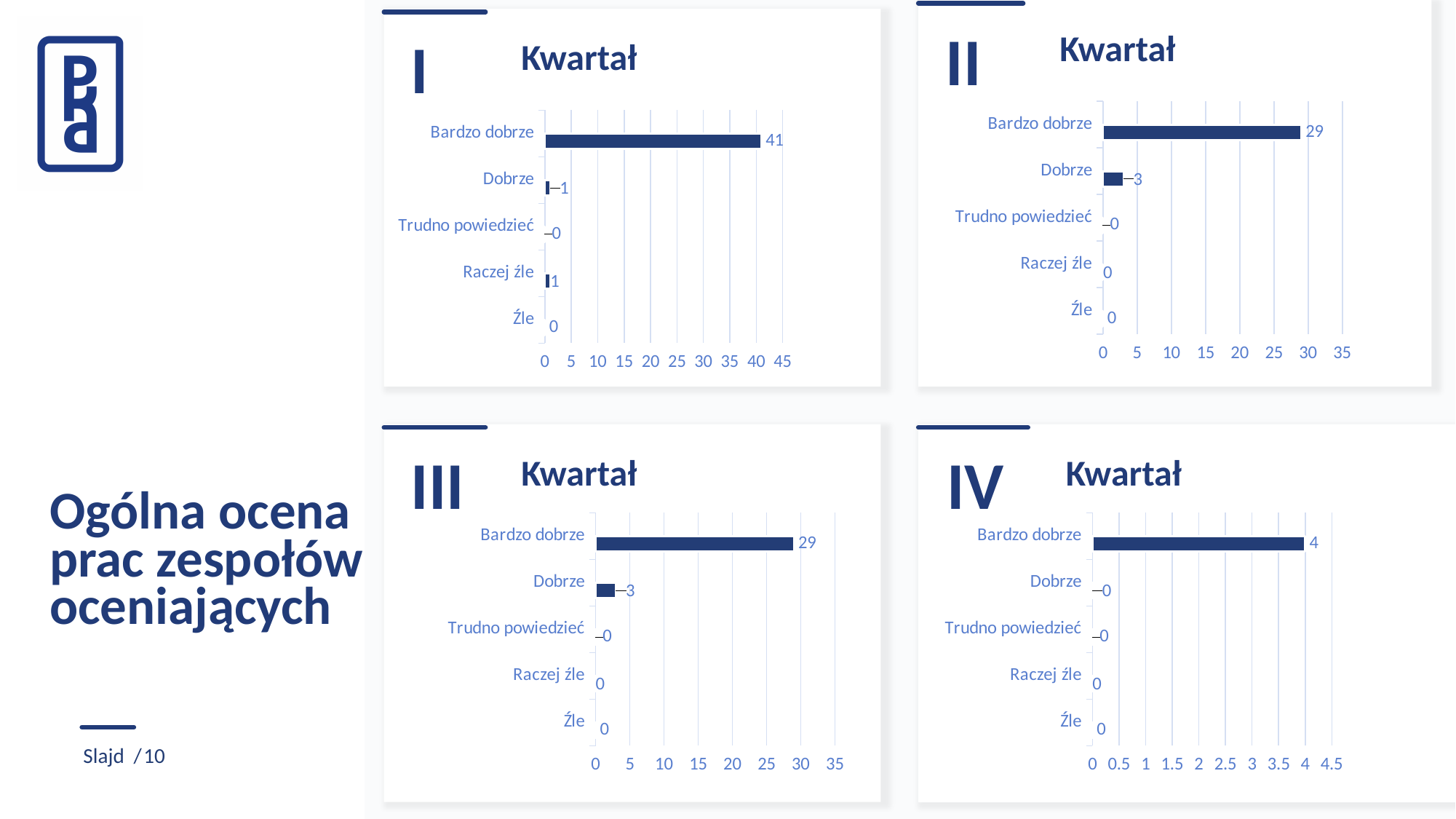
In the III Kwartał chart, which is larger, Bardzo dobrze or Dobrze? Bardzo dobrze In the IV Kwartał chart, what is the value for Bardzo dobrze? 4 What type of chart is the II Kwartał chart? Bar chart In the II Kwartał chart, what is the value for Dobrze? 3 In the I Kwartał chart, what is the difference between Bardzo dobrze and Dobrze? 40 In the I Kwartał chart, which category has the highest value? Bardzo dobrze In the I Kwartał chart, what is the value for Raczej źle? 1 How many charts are shown on the slide? 4 In the III Kwartał chart, what is the value for Trudno powiedzieć? 0 How many categories does the IV Kwartał chart show? 5 In the II Kwartał chart, what is the difference between Bardzo dobrze and Dobrze? 26 In the I Kwartał chart, what is the value for Bardzo dobrze? 41